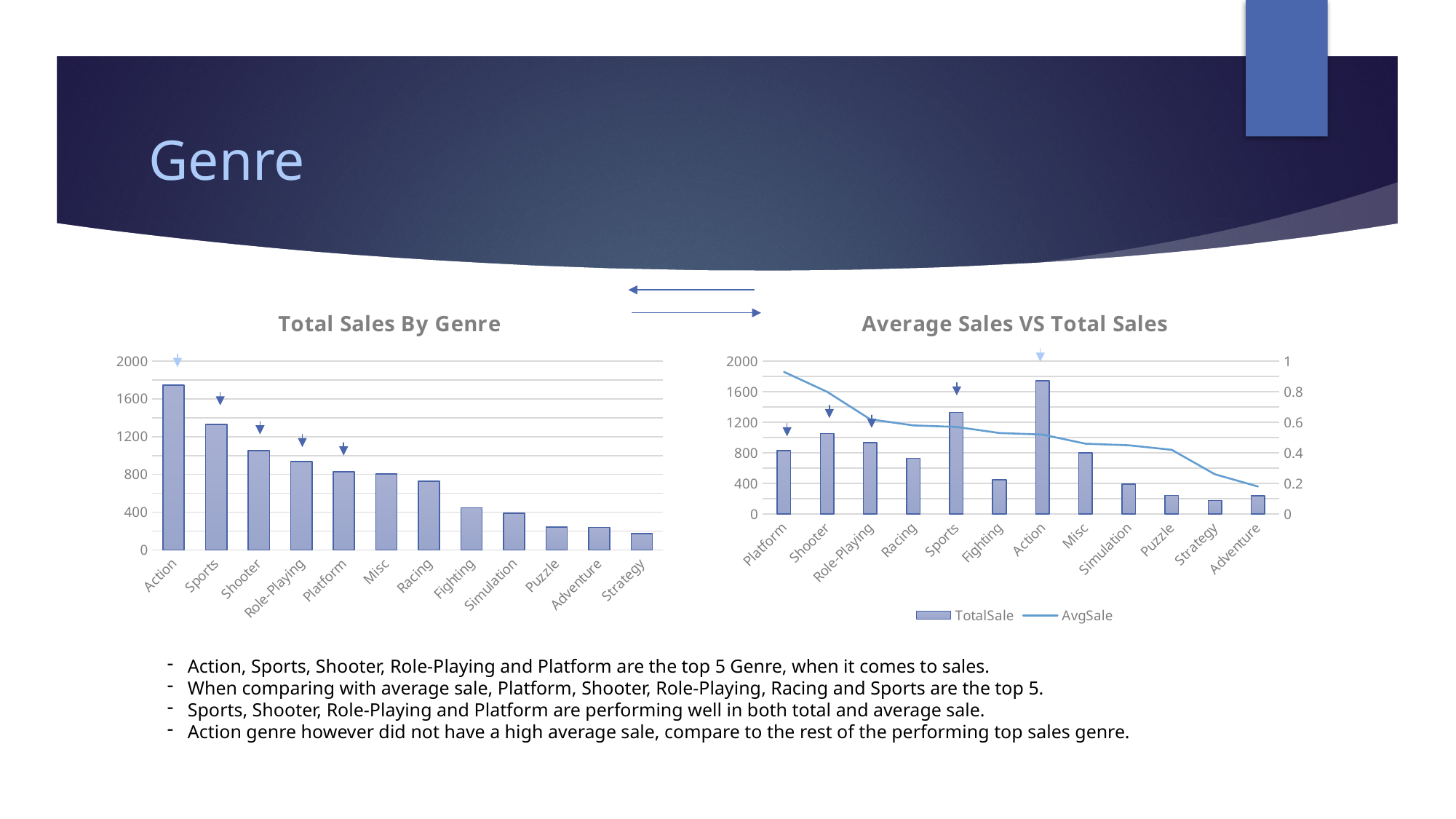
In the Average Sales VS Total Sales chart, which genre has the highest AvgSale? Platform In the Average Sales VS Total Sales chart, which series is drawn as a line? AvgSale What kind of chart is the Total Sales By Genre chart? bar chart In the Total Sales By Genre chart, which genre has the highest total sales? Action In the Total Sales By Genre chart, is the value for Strategy greater or less than 400? less In the Total Sales By Genre chart, is the value for Sports greater or less than 1200? greater In the Total Sales By Genre chart, which genre has the lowest total sales? Strategy In the Total Sales By Genre chart, which has higher total sales, Shooter or Racing? Shooter In the Average Sales VS Total Sales chart, how many series does the legend list? 2 In the Total Sales By Genre chart, is the value for Action greater or less than 1600? greater In the Total Sales By Genre chart, how many genres are shown on the x axis? 12 In the Total Sales By Genre chart, do the values rise or fall from left to right along the x axis? fall